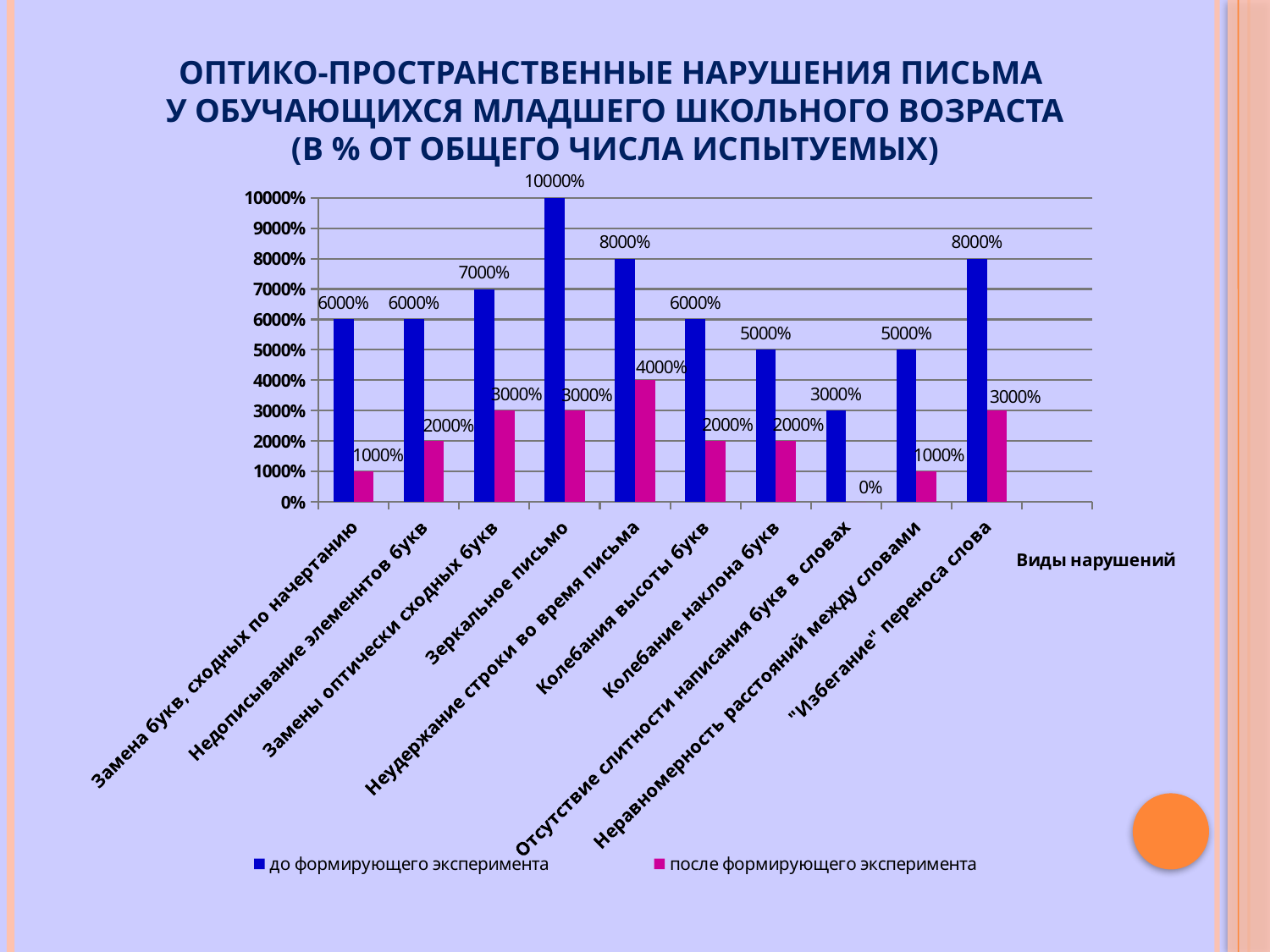
Which category has the lowest value in the series 'после формирующего эксперимента'? Отсутствие слитности написания букв в словах What colour are the bars for the series 'после формирующего эксперимента'? magenta (pink) What is the value for 'Зеркальное письмо' in the series 'до формирующего эксперимента'? 10000% What is the value for '"Избегание" переноса слова' in the series 'до формирующего эксперимента'? 8000% What is the difference between the 'до формирующего эксперимента' and 'после формирующего эксперимента' values for 'Зеркальное письмо'? 7000% What is the value for 'Отсутствие слитности написания букв в словах' in the series 'после формирующего эксперимента'? 0% What type of chart is shown on the slide? bar chart Which category has the highest value in the series 'до формирующего эксперимента'? Зеркальное письмо How many series does the legend list? 2 How many categories of violations are shown on the x axis? 10 Which is larger for 'Колебание наклона букв': the value before the experiment ('до формирующего эксперимента') or after ('после формирующего эксперимента')? до формирующего эксперимента What is the value for 'Неудержание строки во время письма' in the series 'после формирующего эксперимента'? 4000%